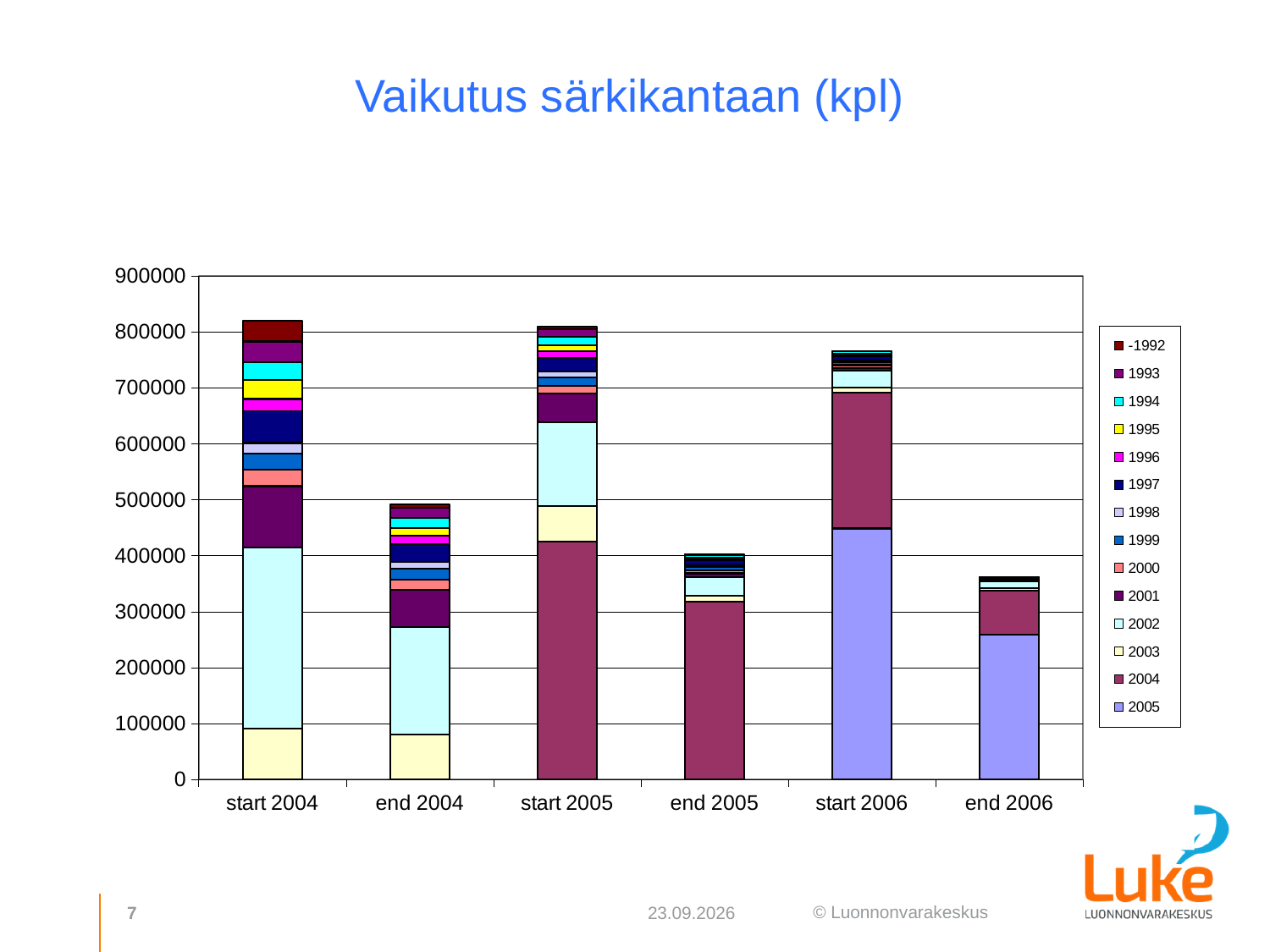
Is the total stacked value for end 2004 greater or less than 500000? less What is the title of the chart? Vaikutus särkikantaan (kpl) Is the total stacked value for start 2004 greater or less than 800000? greater How many categories are shown on the x axis of the chart? 6 Is the total stacked value for start 2006 greater or less than 700000? greater Do the totals of the 'end' bars rise or fall from end 2004 to end 2006? fall How many series does the legend list? 14 Which category has the lowest total stacked value? end 2006 What kind of chart is shown on the slide? stacked bar chart Which has the larger total stacked value, start 2006 or end 2006? start 2006 Which series is the first entry listed in the legend? -1992